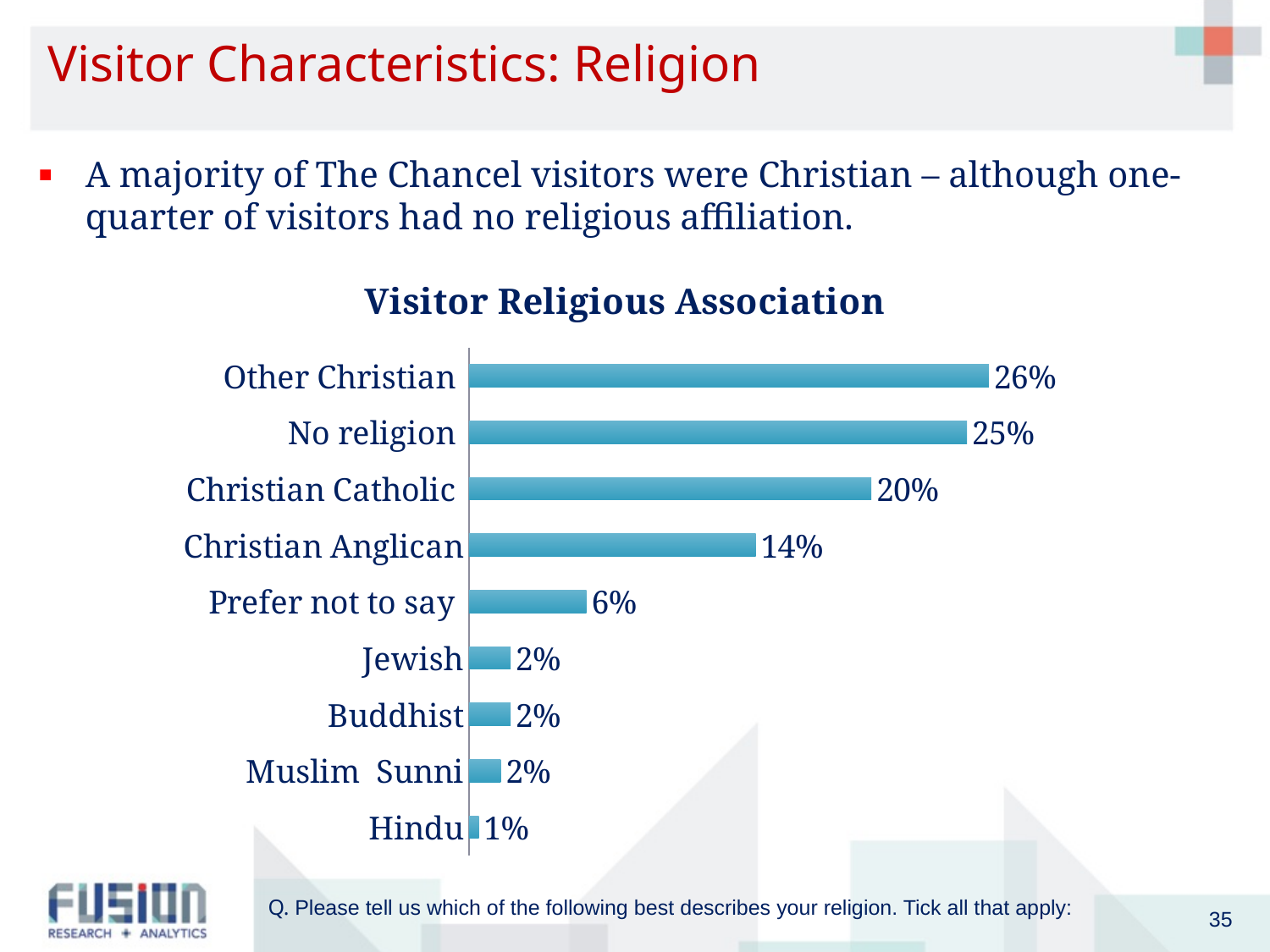
What is the difference between the Other Christian and No religion values? 1% What is the title of the chart? Visitor Religious Association Which is larger, the value for Christian Catholic or the value for Prefer not to say? Christian Catholic What percentage of visitors preferred not to say their religion? 6% How many categories are shown in the chart? 9 What percentage of visitors reported having no religion? 25% Which category has the lowest value in the chart? Hindu What type of chart is shown on the slide? Bar chart What is the value for Christian Anglican? 14% What is the difference between the Christian Catholic and Christian Anglican values? 6% Which category has the highest value in the chart? Other Christian What percentage of visitors identified as Other Christian? 26%